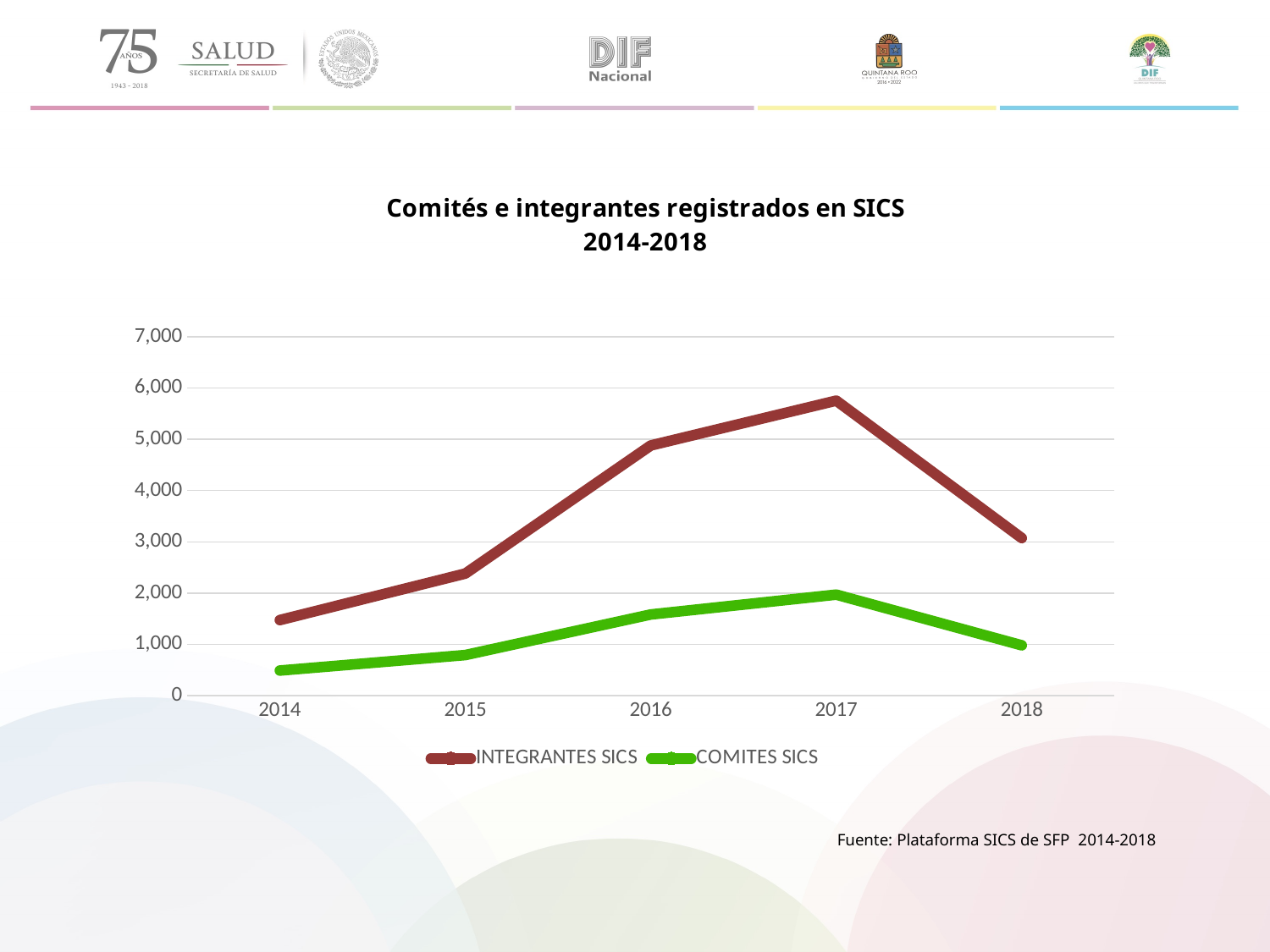
Is the value for COMITES SICS in 2014 greater or less than 1,000? less Does the INTEGRANTES SICS series rise or fall from 2014 to 2017? rise In which year does the COMITES SICS series reach its highest value? 2017 In which year does the INTEGRANTES SICS series reach its highest value? 2017 Is the value for INTEGRANTES SICS in 2017 greater or less than 5,000? greater How many years are plotted along the x axis? 5 In which year is the INTEGRANTES SICS series at its lowest? 2014 How many series does the legend list? 2 Is the value for INTEGRANTES SICS in 2016 greater or less than 4,000? greater What is the title of the chart? Comités e integrantes registrados en SICS 2014-2018 Which series has the higher value in 2016, INTEGRANTES SICS or COMITES SICS? INTEGRANTES SICS What kind of chart is shown on the slide? line chart